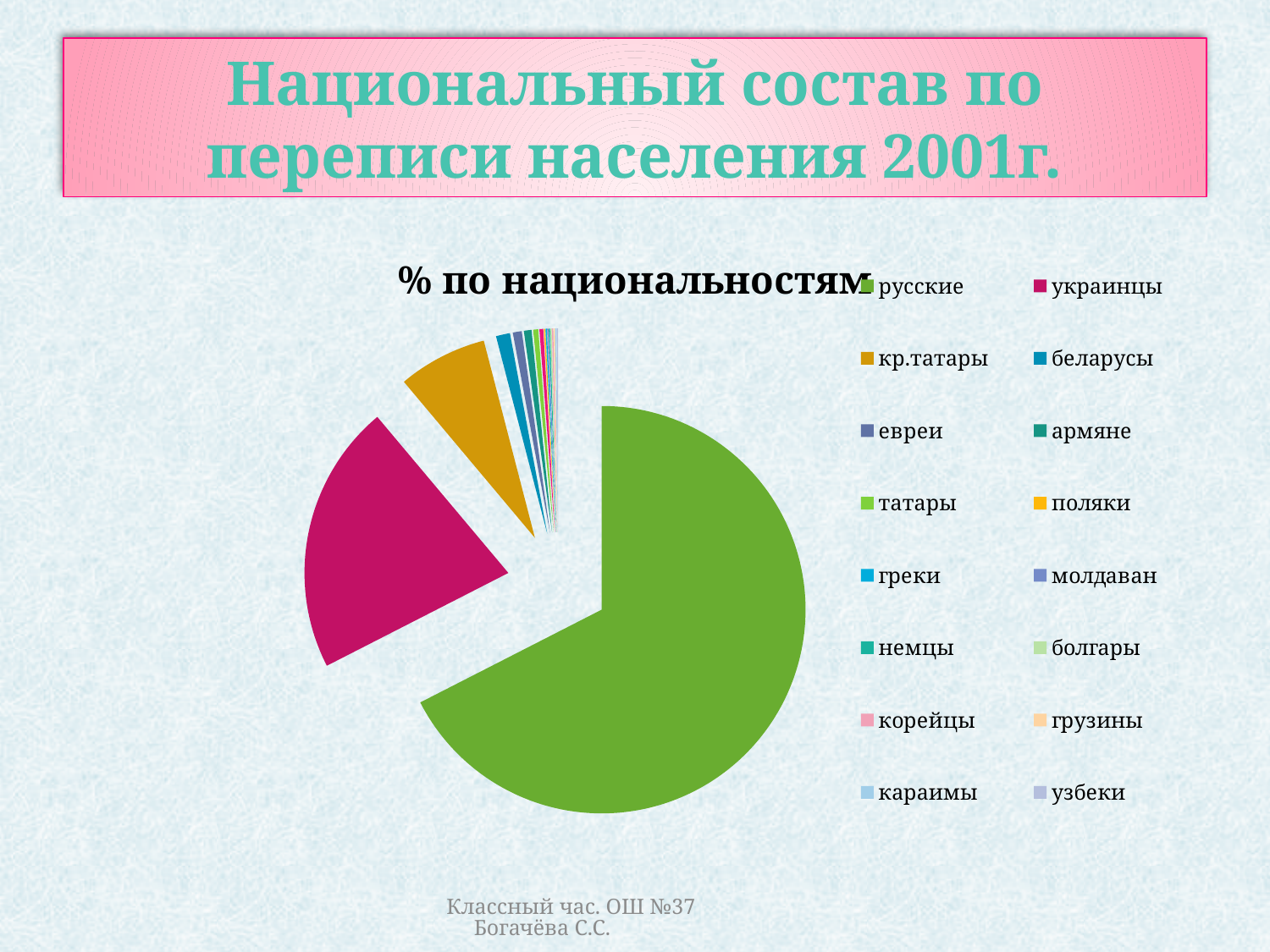
Which slice is larger, украинцы or кр.татары? украинцы Which nationality has the second largest slice of the pie? украинцы Which nationality has the largest slice of the pie? русские What is the title of the chart? % по национальностям What colour is the slice for русские? green Which slice is larger, беларусы or русские? русские Which nationality has the third largest slice of the pie? кр.татары How many nationalities are listed in the chart's legend? 16 What kind of chart is shown on the slide? pie chart Which slice is larger, кр.татары or беларусы? кр.татары